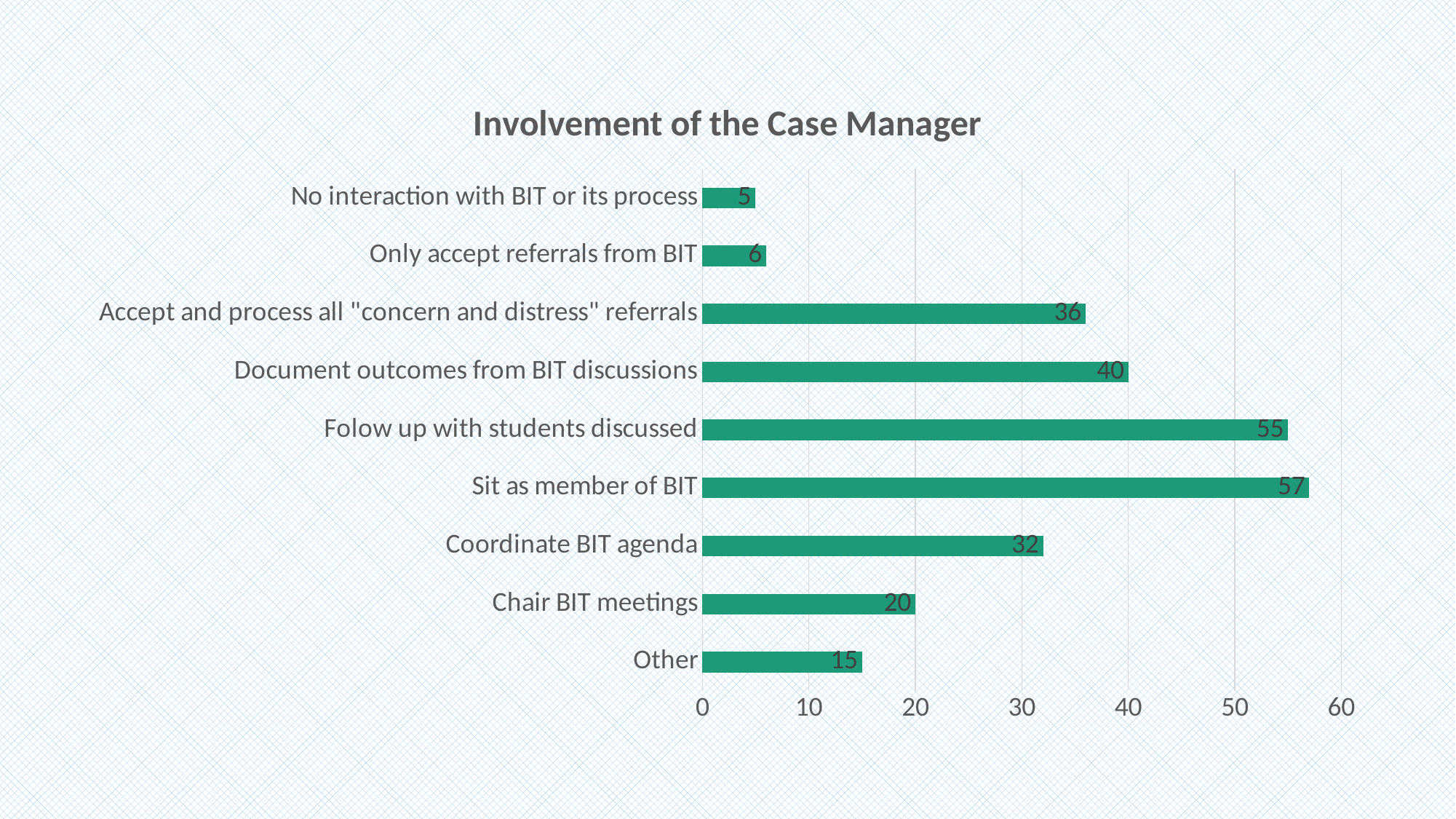
What is the value for "Other"? 15 Which is larger: "Accept and process all "concern and distress" referrals" or "Coordinate BIT agenda"? Accept and process all "concern and distress" referrals What is the title of the chart? Involvement of the Case Manager Is the value for "Follow up with students discussed" greater or less than 50? greater What kind of chart is shown on the slide? bar chart Which category has the highest value? Sit as member of BIT What is the difference between "Follow up with students discussed" and "Coordinate BIT agenda"? 23 What is the value for "Sit as member of BIT"? 57 What is the value for "Chair BIT meetings"? 20 Which category has the lowest value? No interaction with BIT or its process What is the value for "Document outcomes from BIT discussions"? 40 How many categories are shown in the chart? 9